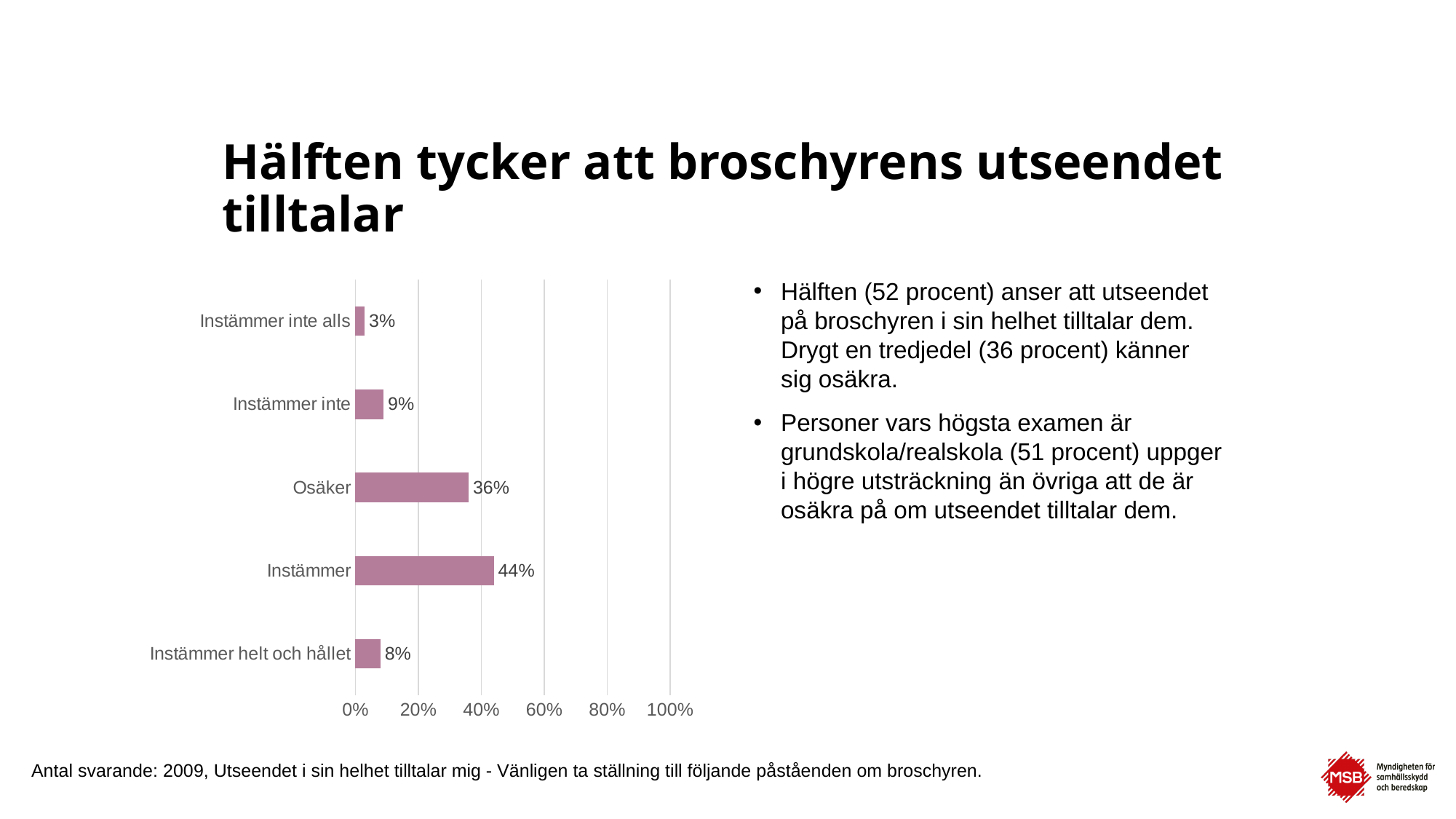
What is the combined value of Instämmer and Instämmer helt och hållet? 52% What is the value for Instämmer helt och hållet? 8% What kind of chart is shown on the slide? bar chart What is the value for Instämmer inte alls? 3% Is the value for Instämmer greater or less than 40%? greater How many categories are shown in the chart? 5 What is the highest value shown on the x axis? 100% Which category has the lowest value? Instämmer inte alls What is the difference between the values for Instämmer and Osäker? 8% Which is larger, the value for Instämmer inte or the value for Instämmer helt och hållet? Instämmer inte What is the value for Osäker? 36% Which category has the highest value? Instämmer